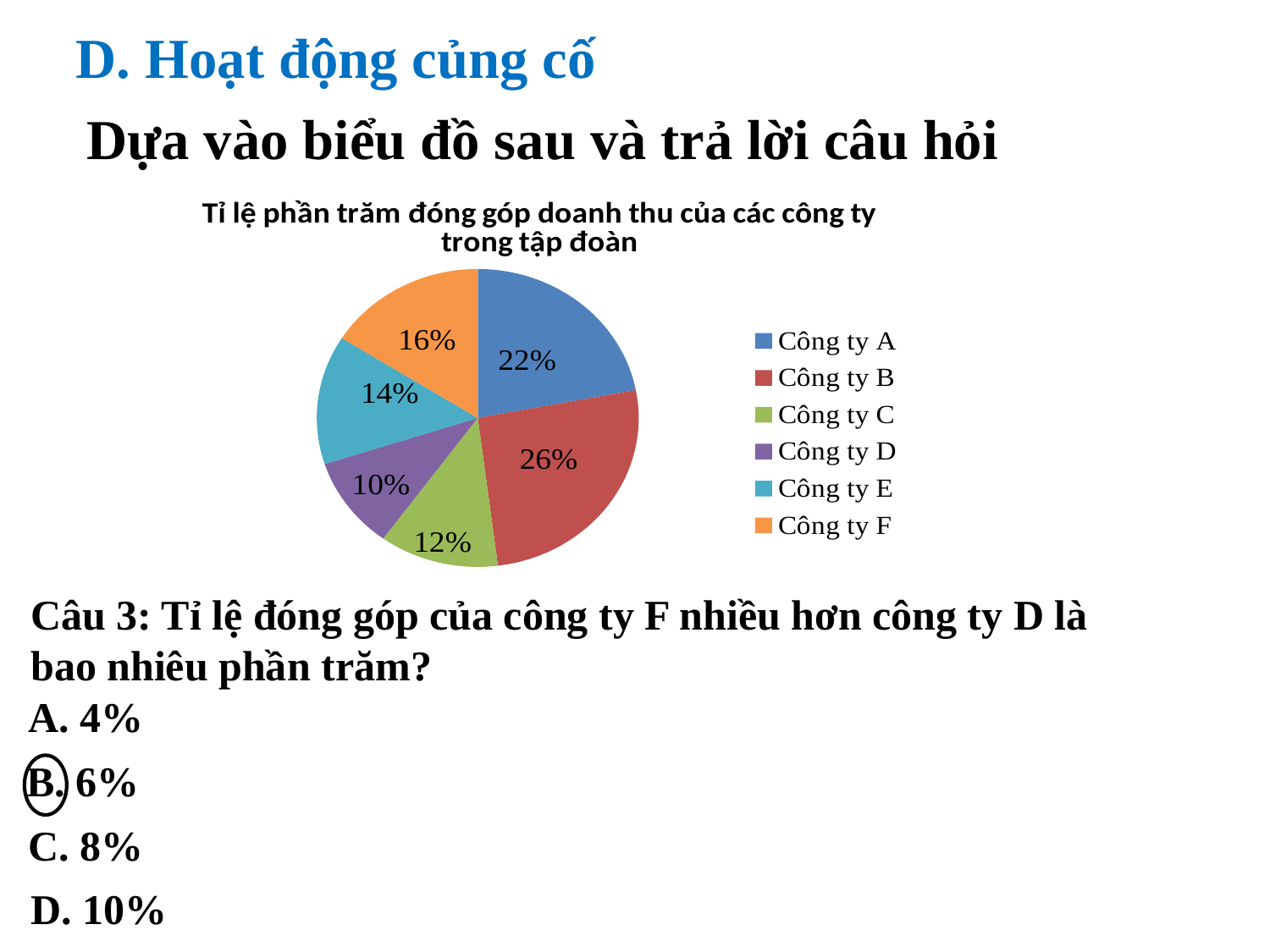
What is the percentage share for Công ty F? 16% What is the percentage share for Công ty D? 10% What is the percentage share for Công ty A? 22% Which has a larger share, Công ty C or Công ty E? Công ty E How many companies are shown in the pie chart? 6 Which company has the smallest share of the pie? Công ty D What is the percentage share for Công ty B? 26% Which company has the largest share of the pie? Công ty B How many percentage points larger is Công ty F's share than Công ty D's share? 6% What kind of chart is shown on the slide? Pie chart What is the difference between the shares of Công ty B and Công ty A? 4% What is the title of the chart? Tỉ lệ phần trăm đóng góp doanh thu của các công ty trong tập đoàn